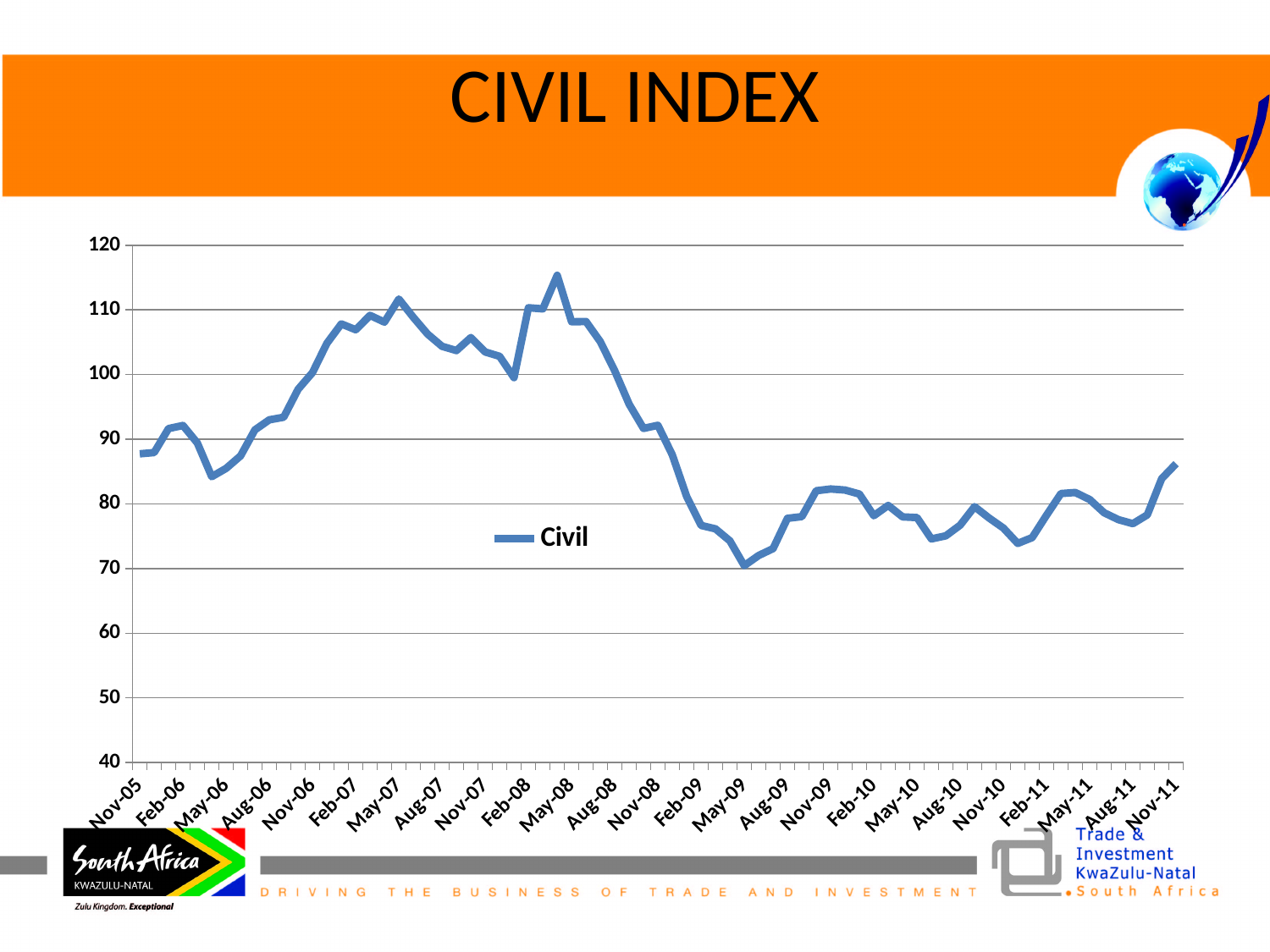
Is the value for May-09 greater or less than 80? less Is the value for Nov-11 greater or less than 80? greater Is the value for May-08 greater or less than 110? less Does the Civil index rise or fall between May-08 and May-09? fall Which is larger, the value for May-08 or the value for May-09? May-08 How many series does the legend list? 1 What is the name of the series shown in the legend? Civil What kind of chart is shown on the slide? line chart What is the title of the slide containing the chart? CIVIL INDEX Around which labelled month does the Civil index reach its lowest value? May-09 Around which labelled month does the Civil index reach its highest value? May-08